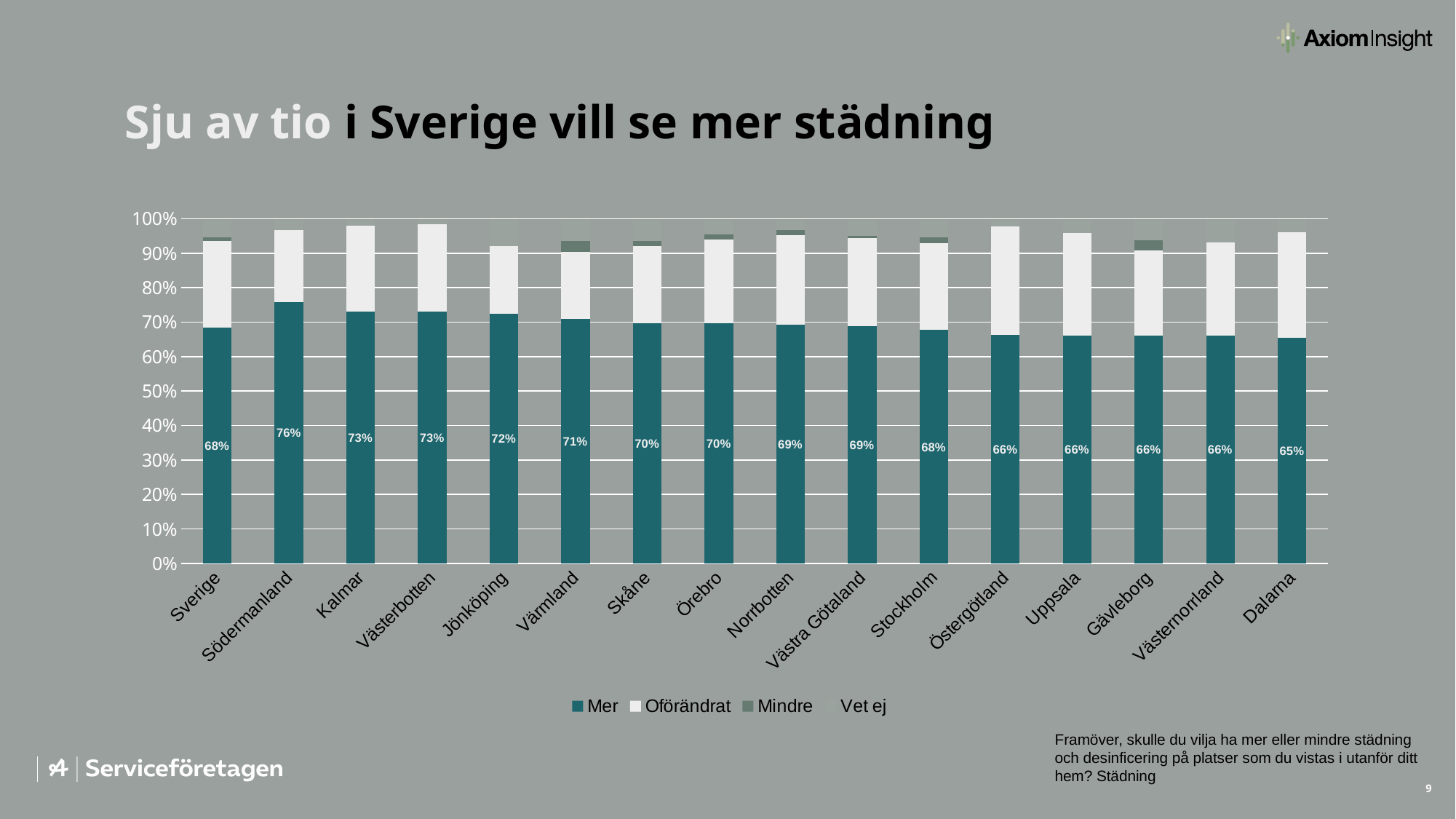
Is the "Mer" value for Dalarna greater or less than 70%? less What is the "Mer" value for Södermanland? 76% How many categories are shown on the x axis? 16 What is the difference in percentage points between the "Mer" value for Södermanland and the "Mer" value for Dalarna? 11 Which category has the highest "Mer" value? Södermanland Which series is shown in dark teal in the legend? Mer How many series does the legend list? 4 What kind of chart is shown on the slide? Stacked bar chart What is the "Mer" value for Dalarna? 65% What is the "Mer" value for Sverige? 68% Which has a larger "Mer" value, Kalmar or Stockholm? Kalmar Which category has the lowest "Mer" value? Dalarna